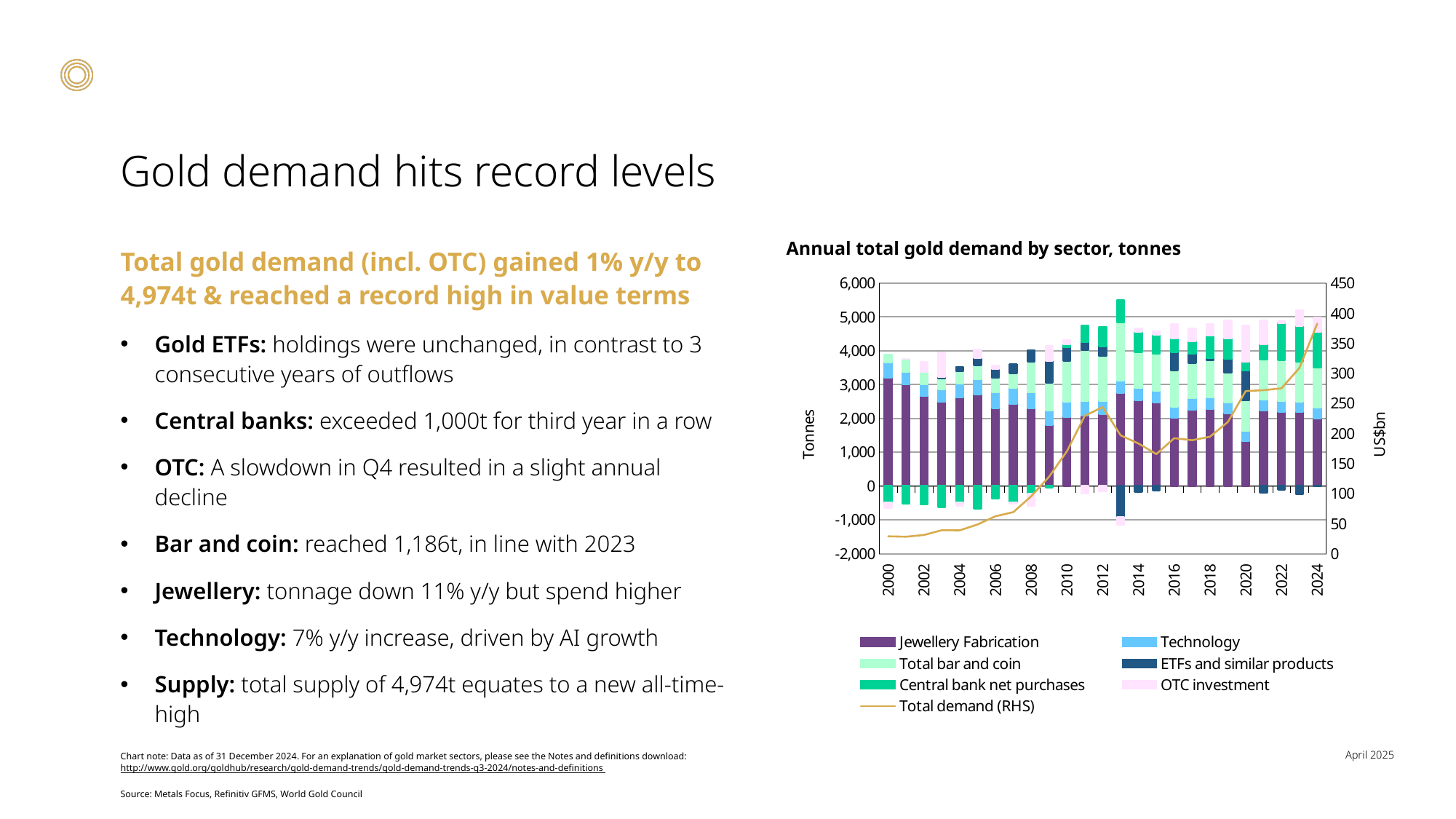
Is the Total demand (RHS) value for 2024 greater or less than 350 US$bn? greater Is the Jewellery Fabrication value for 2020 greater or less than 2,000 tonnes? less In which year does the Total demand (RHS) line reach its highest value? 2024 What kind of chart is shown on the slide? Stacked bar chart with a line What is the title of the chart? Annual total gold demand by sector, tonnes What unit is shown on the right-hand axis? US$bn In which year is the Jewellery Fabrication bar the lowest? 2020 In which year is the ETFs and similar products bar most negative? 2013 Does the Total demand (RHS) line generally rise or fall from 2000 to 2024? Rise How many years are plotted along the x axis? 25 Which year has the larger Jewellery Fabrication value, 2000 or 2020? 2000 How many series does the legend list? 7